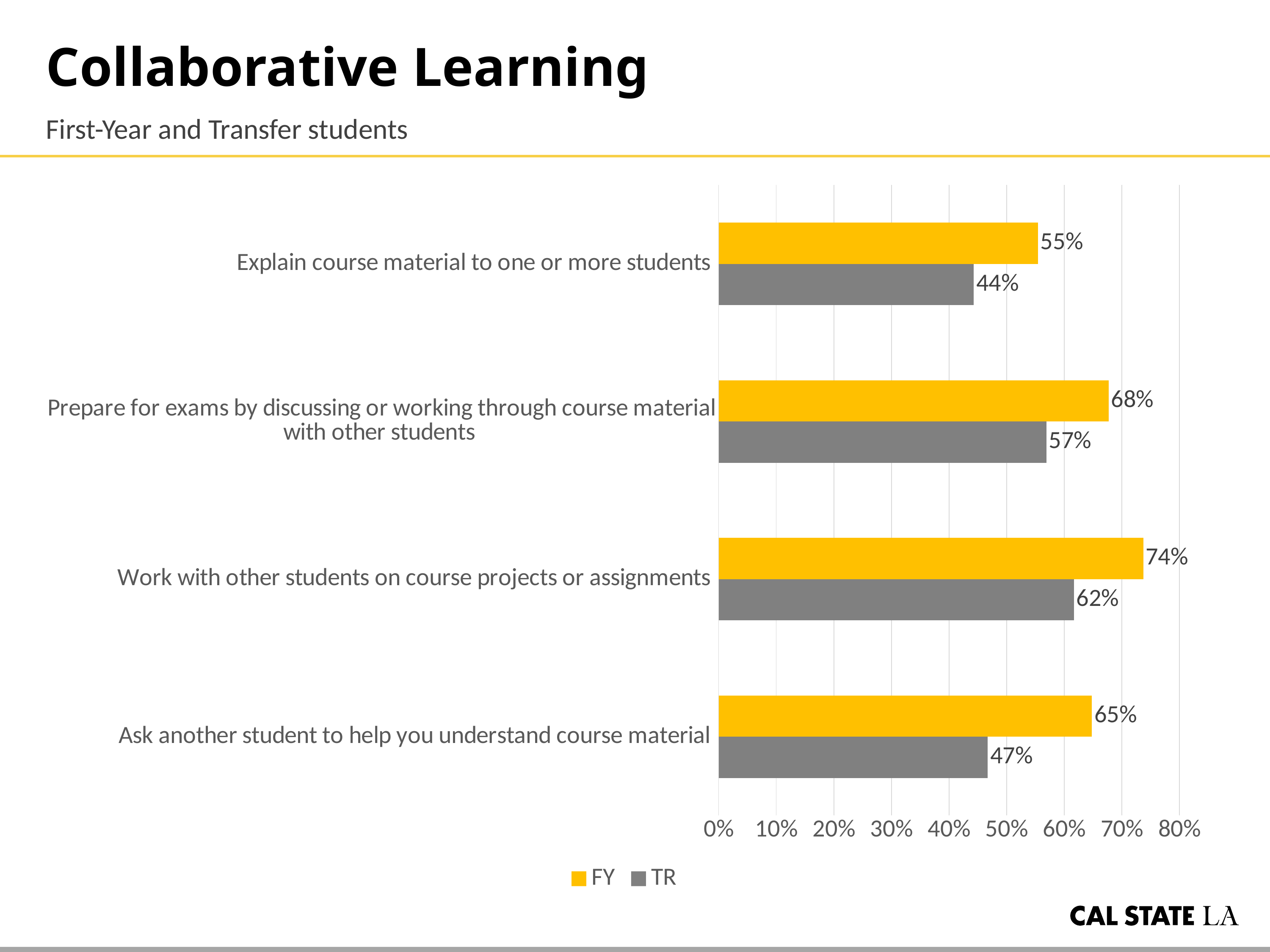
How many series does the legend list? 2 Which category has the highest FY value? Work with other students on course projects or assignments Which is larger for "Prepare for exams by discussing or working through course material with other students": the FY value or the TR value? FY What is the difference between the FY and TR values for "Ask another student to help you understand course material"? 18% What is the TR value for "Prepare for exams by discussing or working through course material with other students"? 57% What is the FY value for "Explain course material to one or more students"? 55% What is the TR value for "Ask another student to help you understand course material"? 47% Which category has the lowest TR value? Explain course material to one or more students How many categories are shown on the chart? 4 What is the difference between the FY and TR values for "Work with other students on course projects or assignments"? 12% What kind of chart is shown on the slide? Bar chart Which colour represents the FY series in the legend? Yellow